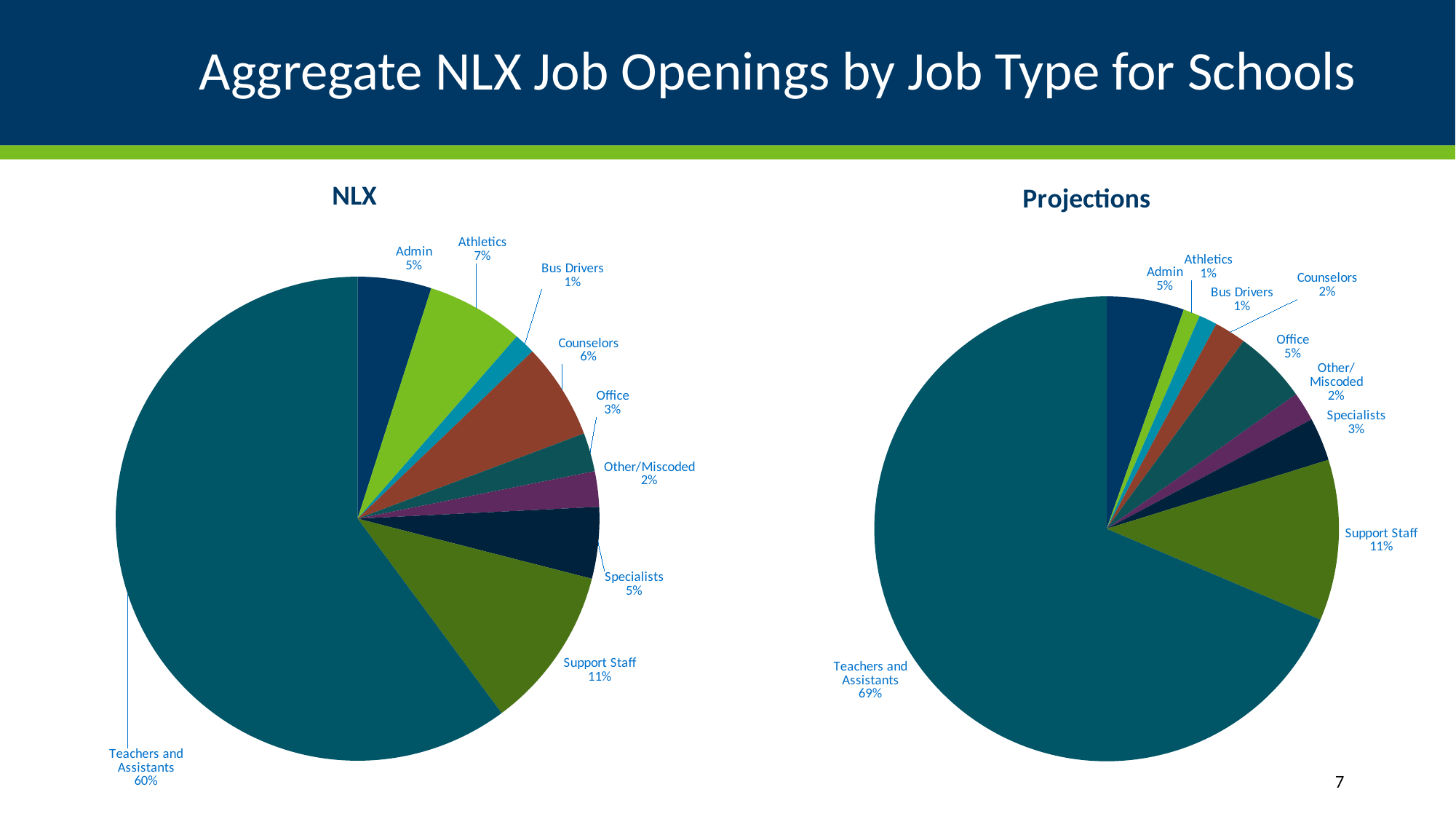
In the NLX chart, what is the difference between Support Staff and Specialists? 6% What type of chart is the NLX chart? Pie chart How many categories does the Projections chart show? 9 In the NLX chart, which category has the smallest slice? Bus Drivers In the Projections chart, what share of job openings is Teachers and Assistants? 69% In the NLX chart, which category has the largest slice? Teachers and Assistants In the Projections chart, what is the value for Office? 5% In the Projections chart, which category has the largest slice? Teachers and Assistants What is the title of the chart on the right side of the slide? Projections In the NLX chart, what share of job openings is Teachers and Assistants? 60% In the NLX chart, which is larger, Counselors or Office? Counselors In the NLX chart, what is the value for Athletics? 7%